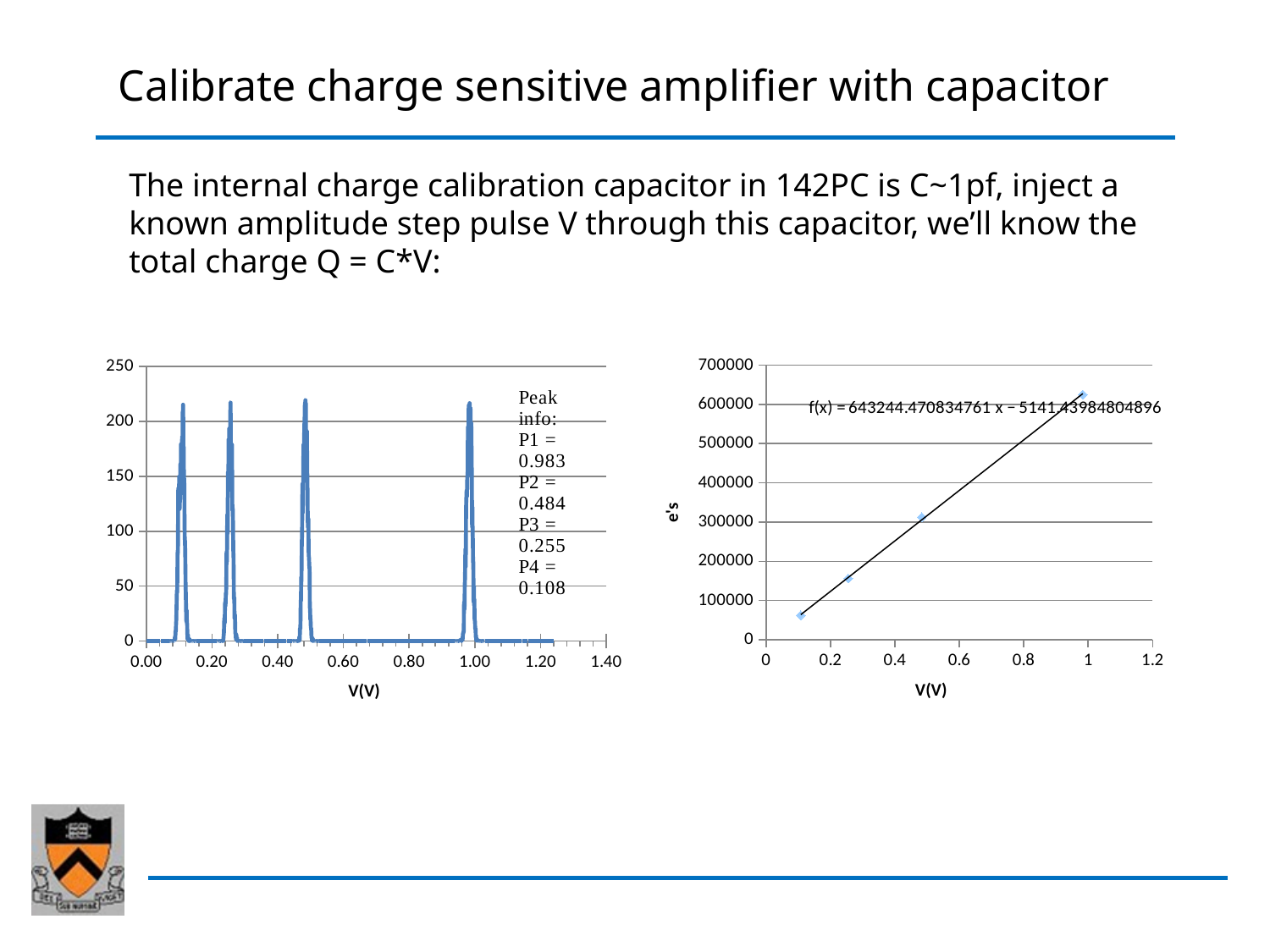
How many peaks are shown in the left chart? 4 In the right chart, do the plotted values rise or fall as V(V) increases? rise In the left chart, what is the value listed for P1 in the peak info? 0.983 In the left chart, what is the value listed for P4 in the peak info? 0.108 What kind of chart is the left chart on the slide? line chart What is the trendline equation shown in the right chart? f(x) = 643244.470834761 x − 5141.43984804896 What is the y-axis label of the right chart? e's What kind of chart is the right chart on the slide? scatter chart In the right chart, is the value of the point near V = 1 greater or less than 600000? greater In the right chart, is the value of the point near V = 0.1 greater or less than 100000? less How many data points are plotted in the right chart? 4 In the left chart, is the height of the peak near V = 0.98 greater or less than 200? greater